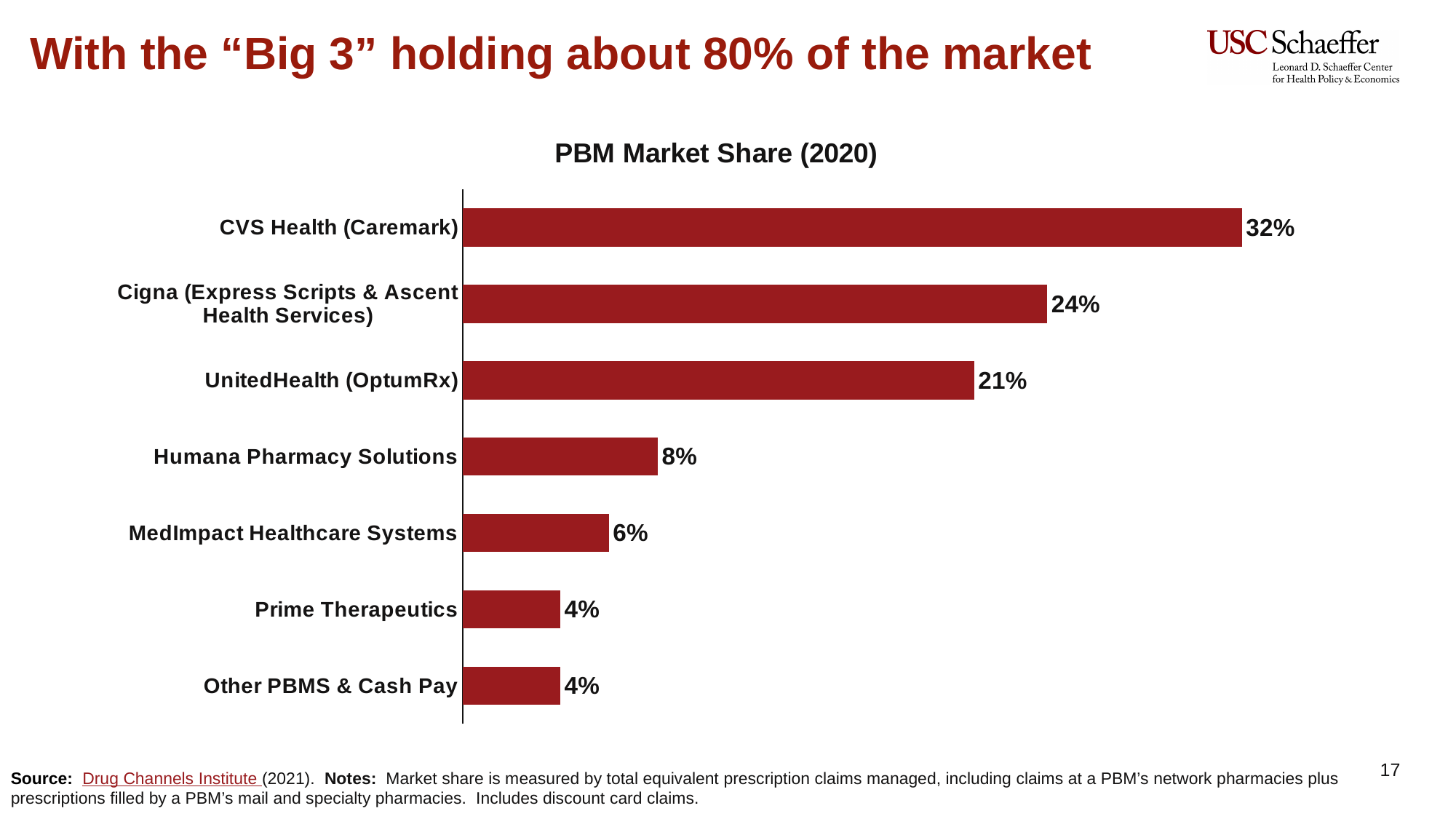
What is the market share for UnitedHealth (OptumRx)? 21% How many categories are shown in the chart? 7 What is the difference in market share between Humana Pharmacy Solutions and Prime Therapeutics? 4% What is the market share for CVS Health (Caremark)? 32% Which has a larger market share, MedImpact Healthcare Systems or Humana Pharmacy Solutions? Humana Pharmacy Solutions What is the difference in market share between CVS Health (Caremark) and Cigna (Express Scripts & Ascent Health Services)? 8% What is the market share for MedImpact Healthcare Systems? 6% What is the title of the chart? PBM Market Share (2020) What kind of chart is shown on the slide? Bar chart What is the market share for Humana Pharmacy Solutions? 8% Which category has the highest market share? CVS Health (Caremark) Which has a larger market share, Cigna (Express Scripts & Ascent Health Services) or UnitedHealth (OptumRx)? Cigna (Express Scripts & Ascent Health Services)